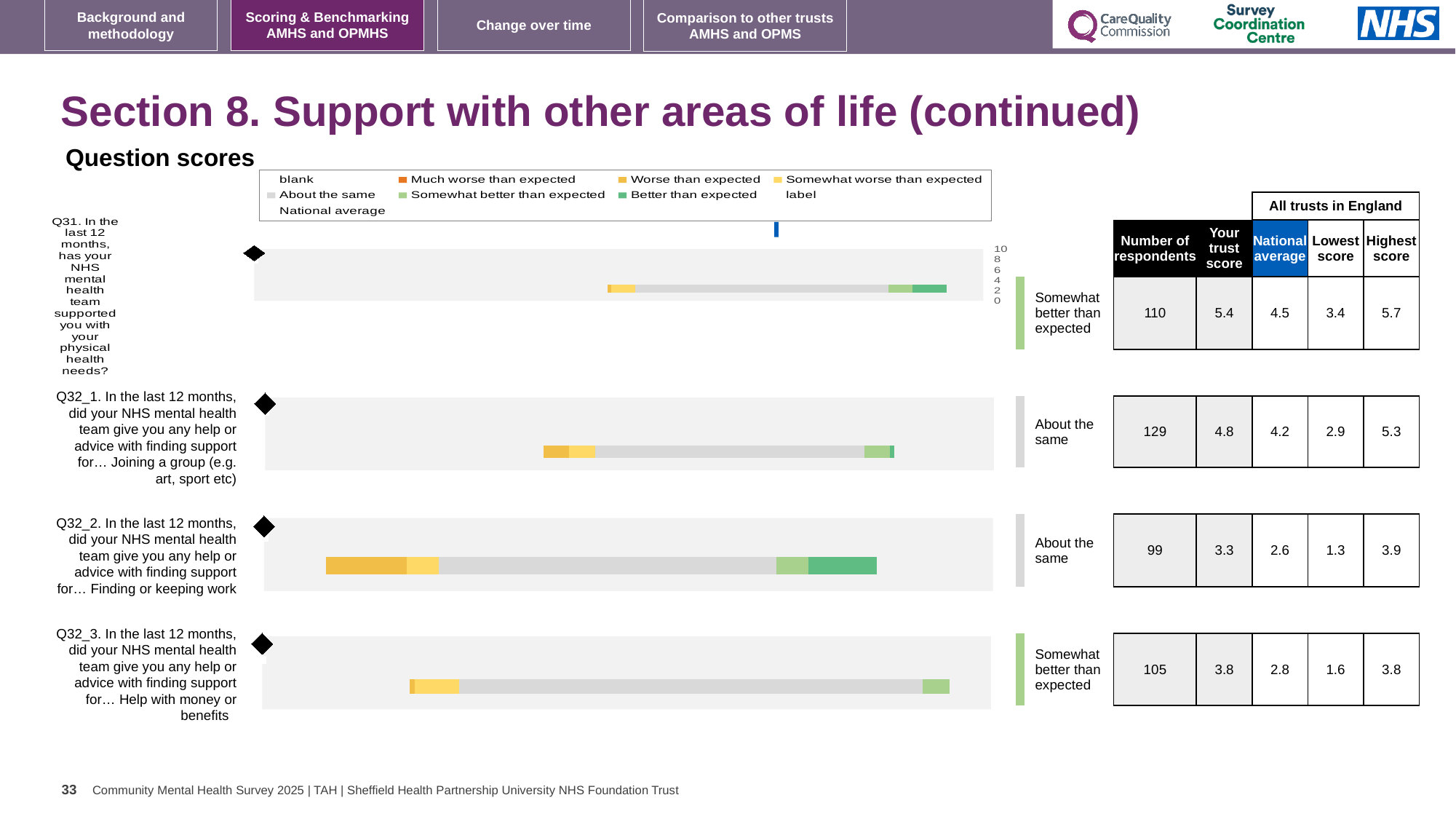
What is the trust score for Q31 (support with physical health needs)? 5.4 What is the national average for Q32_2 (finding or keeping work)? 2.6 What benchmark rating is shown for Q31 (support with physical health needs)? Somewhat better than expected What is the difference between the trust score and the national average for Q31? 0.9 How many questions (bars) are plotted in the question scores chart? 4 What benchmark rating is shown for Q32_2 (finding or keeping work)? About the same For Q32_1 (joining a group), is the trust score higher or lower than the national average? higher Which question has the lowest trust score? Q32_2 What kind of chart is used to show the question scores on this slide? bar chart Which question has the highest trust score? Q31 What is the difference between the highest score and the lowest score for Q32_3? 2.2 How many respondents answered Q32_3 (help with money or benefits)? 105